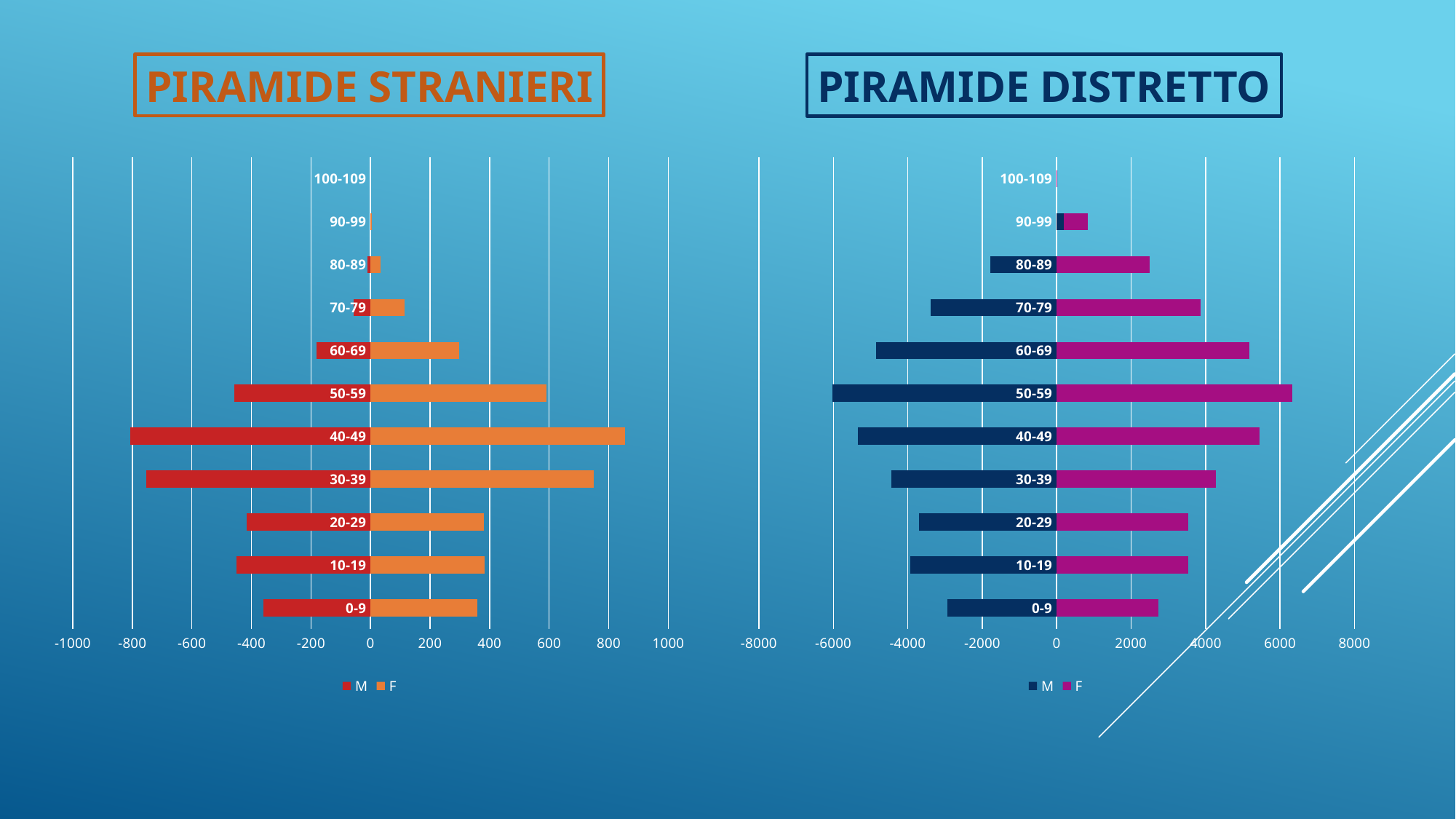
How many age groups are shown on the PIRAMIDE DISTRETTO chart? 11 What kind of chart is the PIRAMIDE STRANIERI chart? bar chart In the PIRAMIDE STRANIERI chart, is the F value for 60-69 greater or less than 400? less In the PIRAMIDE DISTRETTO chart, is the F value for 0-9 greater or less than 2000? greater In the PIRAMIDE STRANIERI chart, which F bar is longer: 40-49 or 0-9? 40-49 What are the two legend entries of the PIRAMIDE DISTRETTO chart? M and F In the PIRAMIDE DISTRETTO chart, which age group has the shortest bars? 100-109 In the PIRAMIDE DISTRETTO chart, is the F value for 50-59 greater or less than 6000? greater How many series does the legend of the PIRAMIDE STRANIERI chart list? 2 In the PIRAMIDE STRANIERI chart, which age group has the longest F bar? 40-49 In the PIRAMIDE DISTRETTO chart, which age group has the longest F bar? 50-59